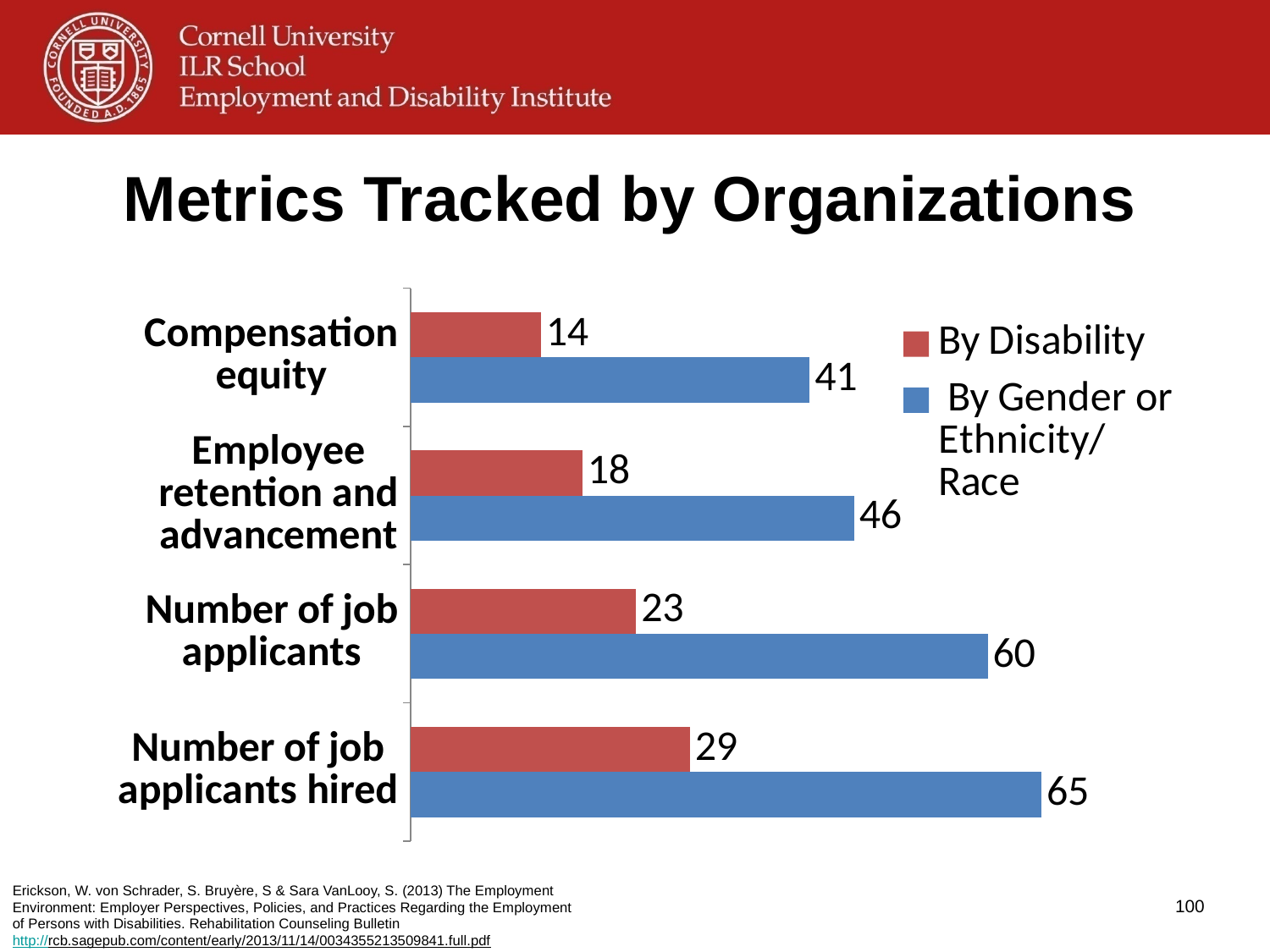
What is the difference between the 'By Gender or Ethnicity/Race' and 'By Disability' values for Number of job applicants? 37 What colour are the 'By Disability' bars? Red Which is larger: the 'By Disability' value for Number of job applicants hired or the 'By Gender or Ethnicity/Race' value for Compensation equity? By Gender or Ethnicity/Race value for Compensation equity What is the value for 'By Disability' for Compensation equity? 14 What is the value for 'By Gender or Ethnicity/Race' for Number of job applicants hired? 65 What kind of chart is shown on the slide? Bar chart Which category has the lowest 'By Gender or Ethnicity/Race' value? Compensation equity What is the value for 'By Gender or Ethnicity/Race' for Employee retention and advancement? 46 How many categories are shown on the chart? 4 Which category has the highest 'By Disability' value? Number of job applicants hired How many series does the legend list? 2 What is the title of the slide? Metrics Tracked by Organizations